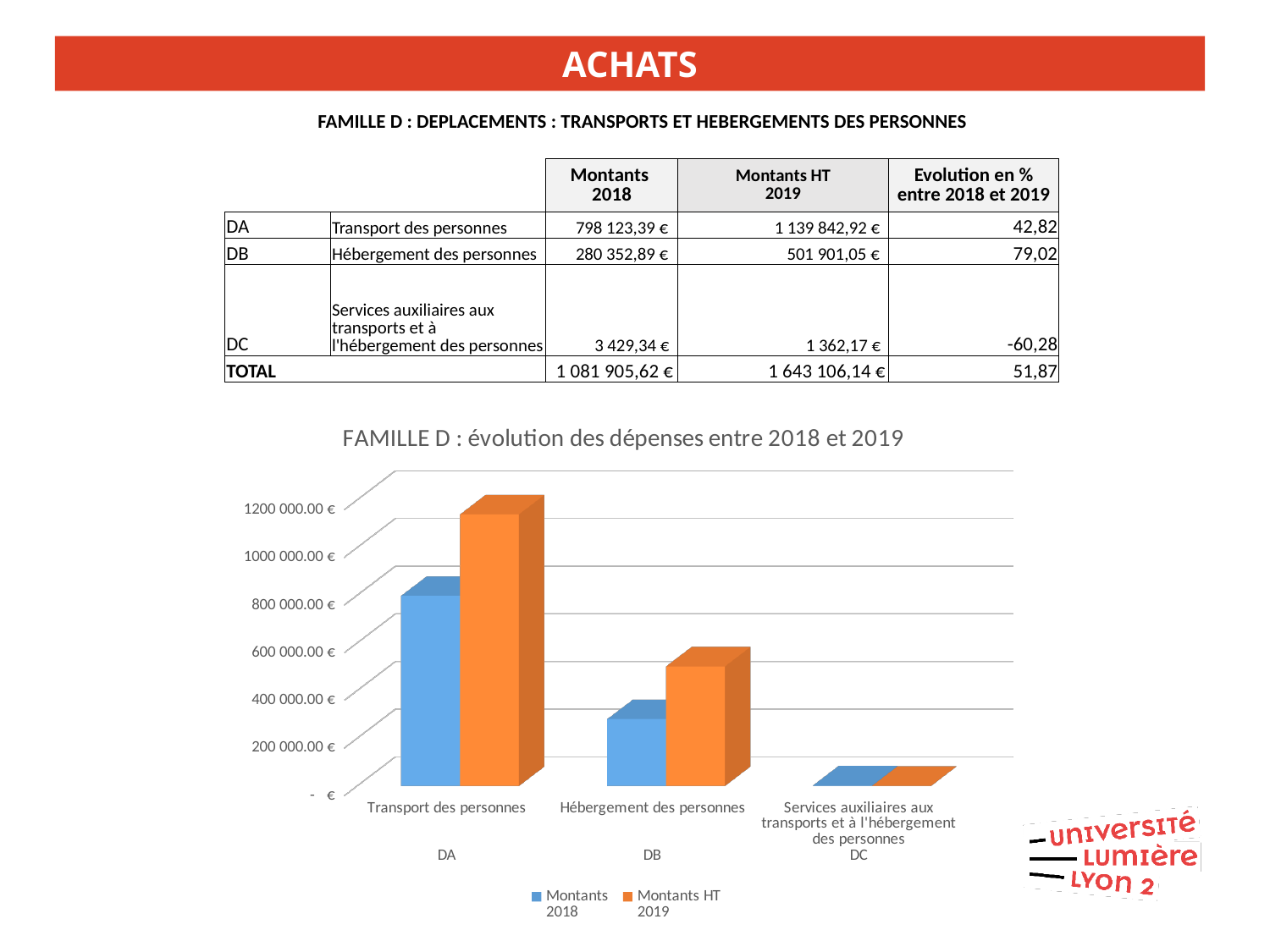
What kind of chart is shown on the slide? bar chart Which colour represents the Montants HT 2019 series in the chart? orange For Hébergement des personnes, which is larger: Montants 2018 or Montants HT 2019? Montants HT 2019 How many series does the chart legend list? 2 How many categories are shown on the x axis of the chart? 3 Which category has the lowest Montants 2018 value in the chart? Services auxiliaires aux transports et à l'hébergement des personnes What is the title of the chart? FAMILLE D : évolution des dépenses entre 2018 et 2019 Is the Montants 2018 value for Hébergement des personnes greater or less than 400 000.00 €? less What is the Montants HT 2019 value for Hébergement des personnes (DB)? 501 901,05 € Is the Montants HT 2019 value for Transport des personnes greater or less than 1000 000.00 €? greater What is the Montants 2018 value for Transport des personnes (DA)? 798 123,39 € Which category has the highest Montants HT 2019 value in the chart? Transport des personnes